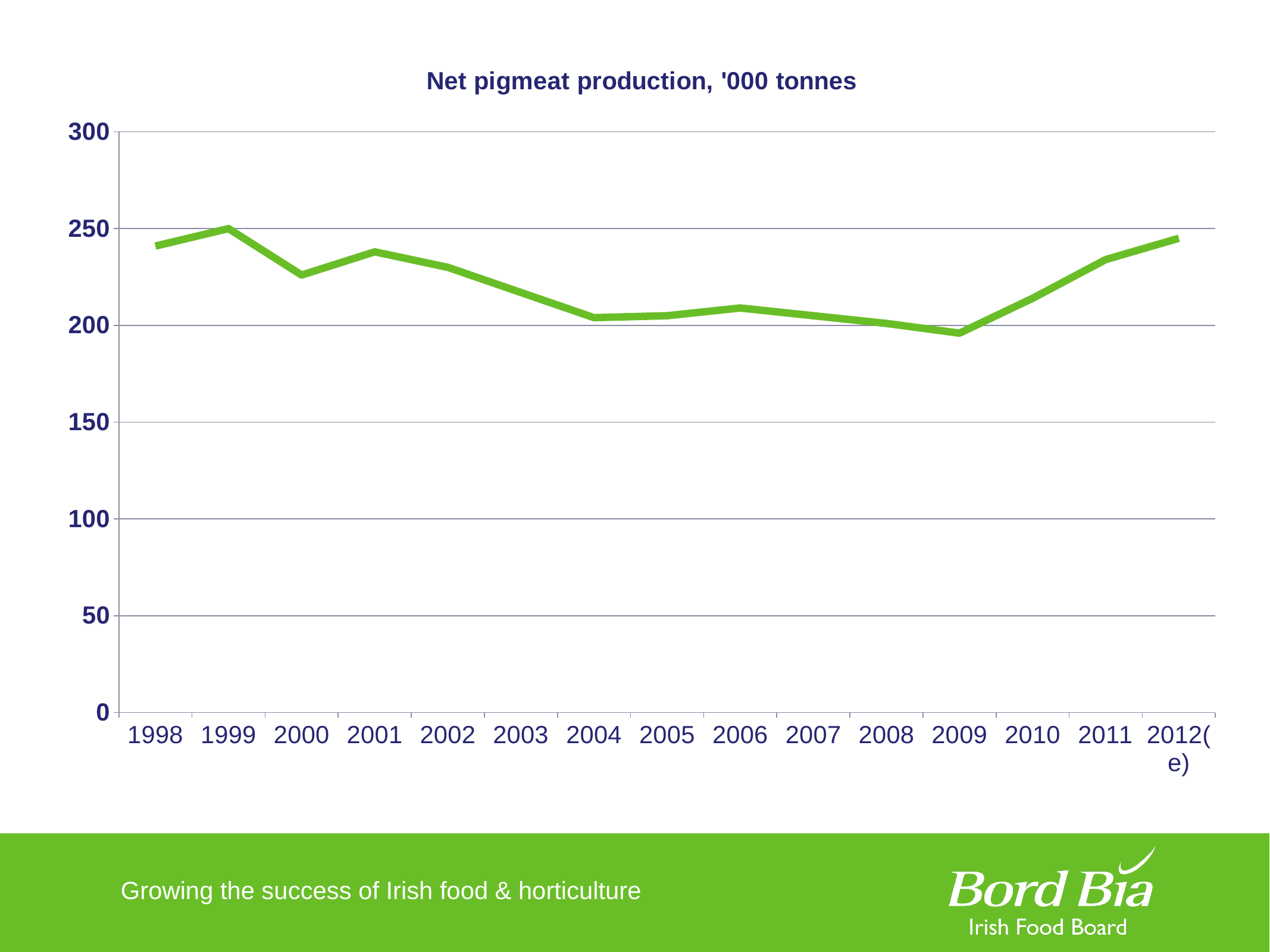
Which year has the larger value, 2001 or 2004? 2001 Is the value for 2003 greater or less than 250? less What is the title of the chart? Net pigmeat production, '000 tonnes Which year has the larger value, 1998 or 2000? 1998 Is the value for 2011 greater or less than 200? greater Is the value for 2000 greater or less than 200? greater How many years are plotted on the x axis of the chart? 15 Does net pigmeat production rise or fall from 1999 to 2004? fall Which year has the highest net pigmeat production? 1999 Does net pigmeat production rise or fall from 2009 to 2012(e)? rise What kind of chart is shown on the slide? line chart Which year has the lowest net pigmeat production? 2009